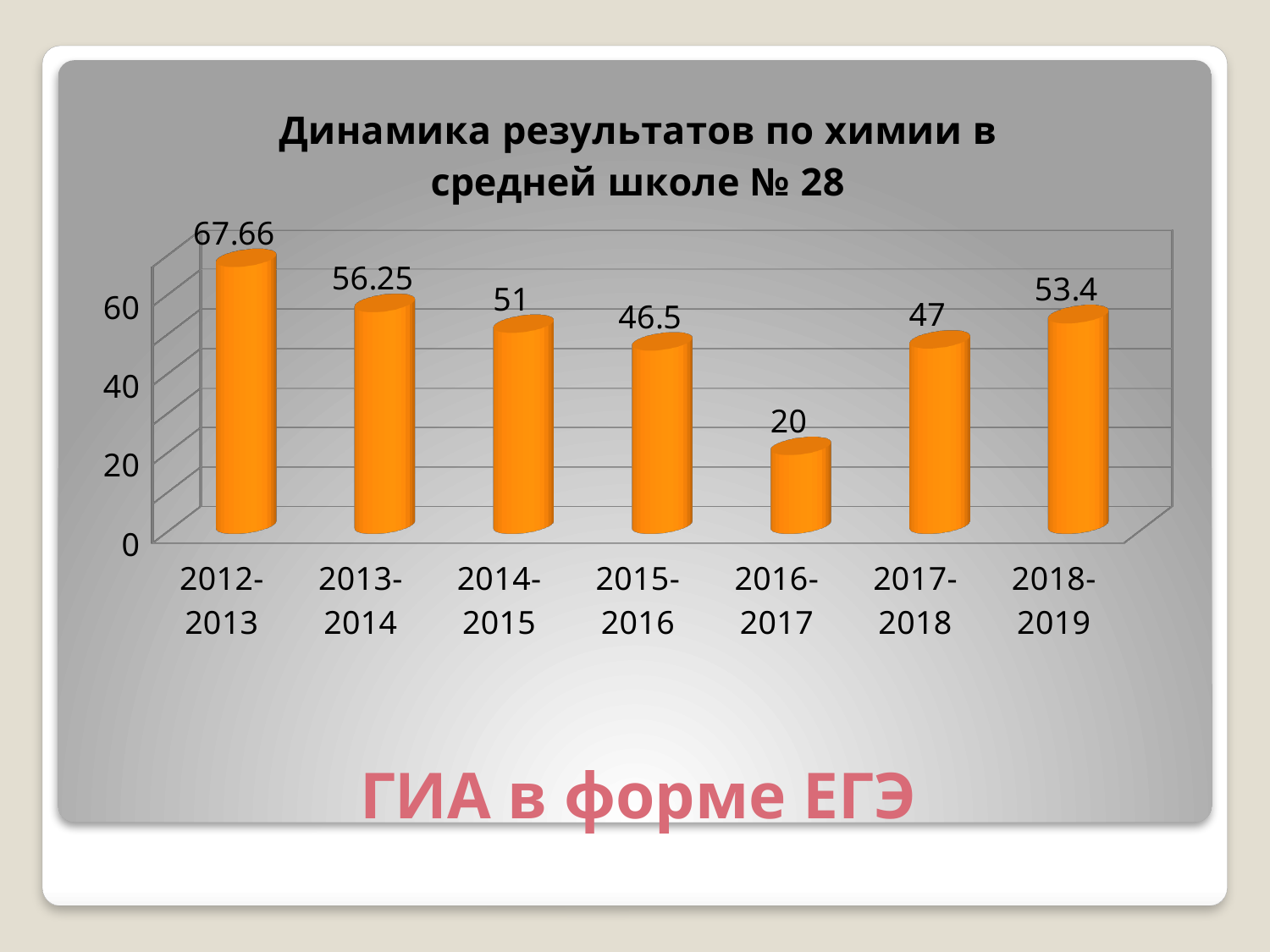
Do the values rise or fall from 2012-2013 to 2016-2017? fall Which is larger, the value for 2014-2015 or the value for 2018-2019? 2018-2019 Which year has the lowest value? 2016-2017 What is the value for 2012-2013? 67.66 What kind of chart is shown on the slide? bar chart Which year has the highest value? 2012-2013 How many years are shown on the x axis? 7 What is the difference between the values for 2012-2013 and 2013-2014? 11.41 What is the value for 2018-2019? 53.4 Is the value for 2015-2016 greater or less than 40? greater What is the difference between the values for 2017-2018 and 2016-2017? 27 What is the value for 2016-2017? 20